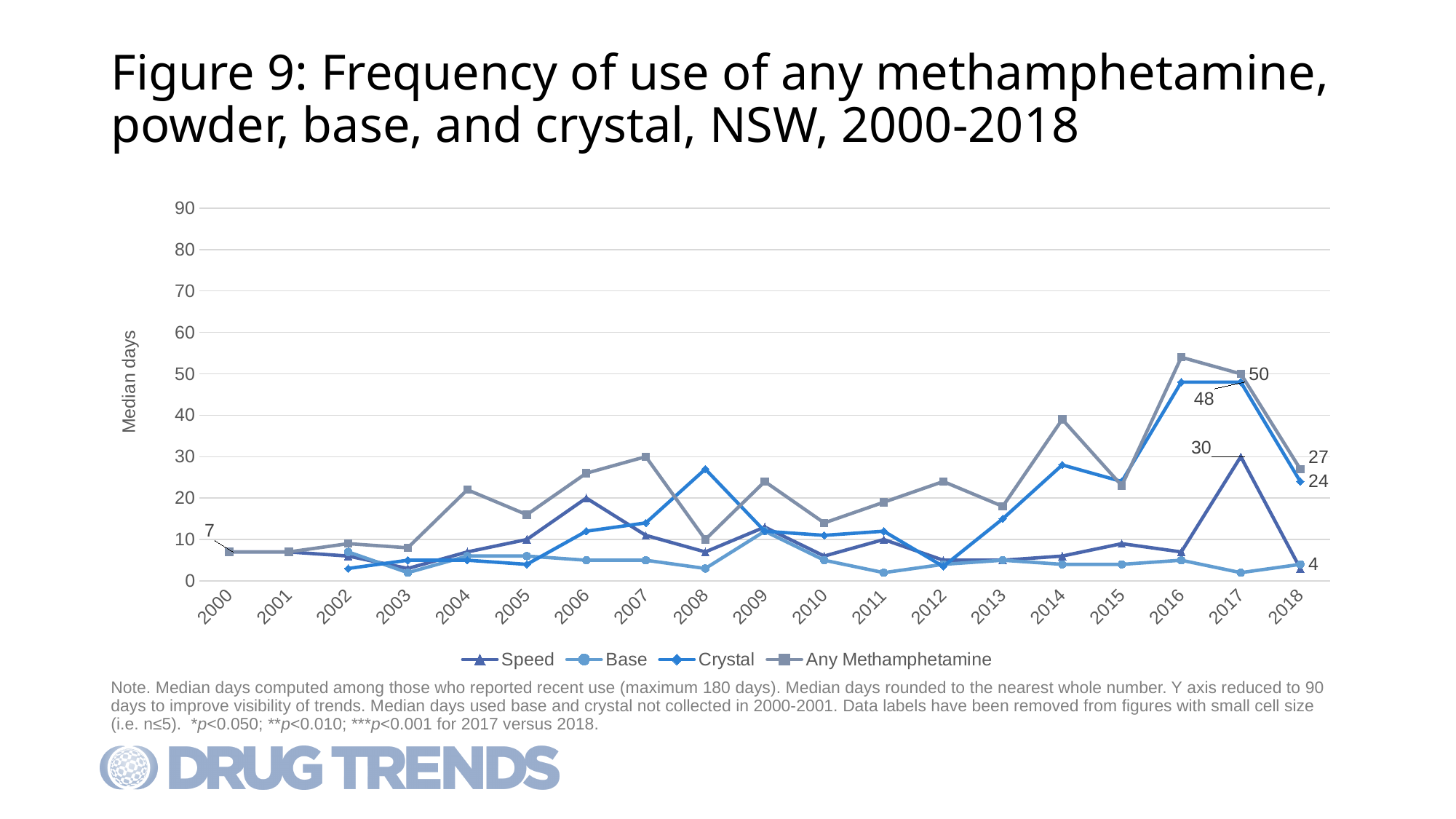
What kind of chart is shown on the slide? Line chart How many series does the legend list? 4 By how much did the Any Methamphetamine value fall from 2017 to 2018? 23 What is the value for Crystal in 2017? 48 What is the value for Any Methamphetamine in 2017? 50 Is the value for Any Methamphetamine in 2016 greater or less than 50? greater What is the value for Any Methamphetamine in 2018? 27 How many years are shown on the x axis? 19 What is the value for Crystal in 2018? 24 In 2017, which is larger: the Crystal value or the Any Methamphetamine value? Any Methamphetamine What is the value for Base in 2018? 4 What is the value for Speed in 2017? 30